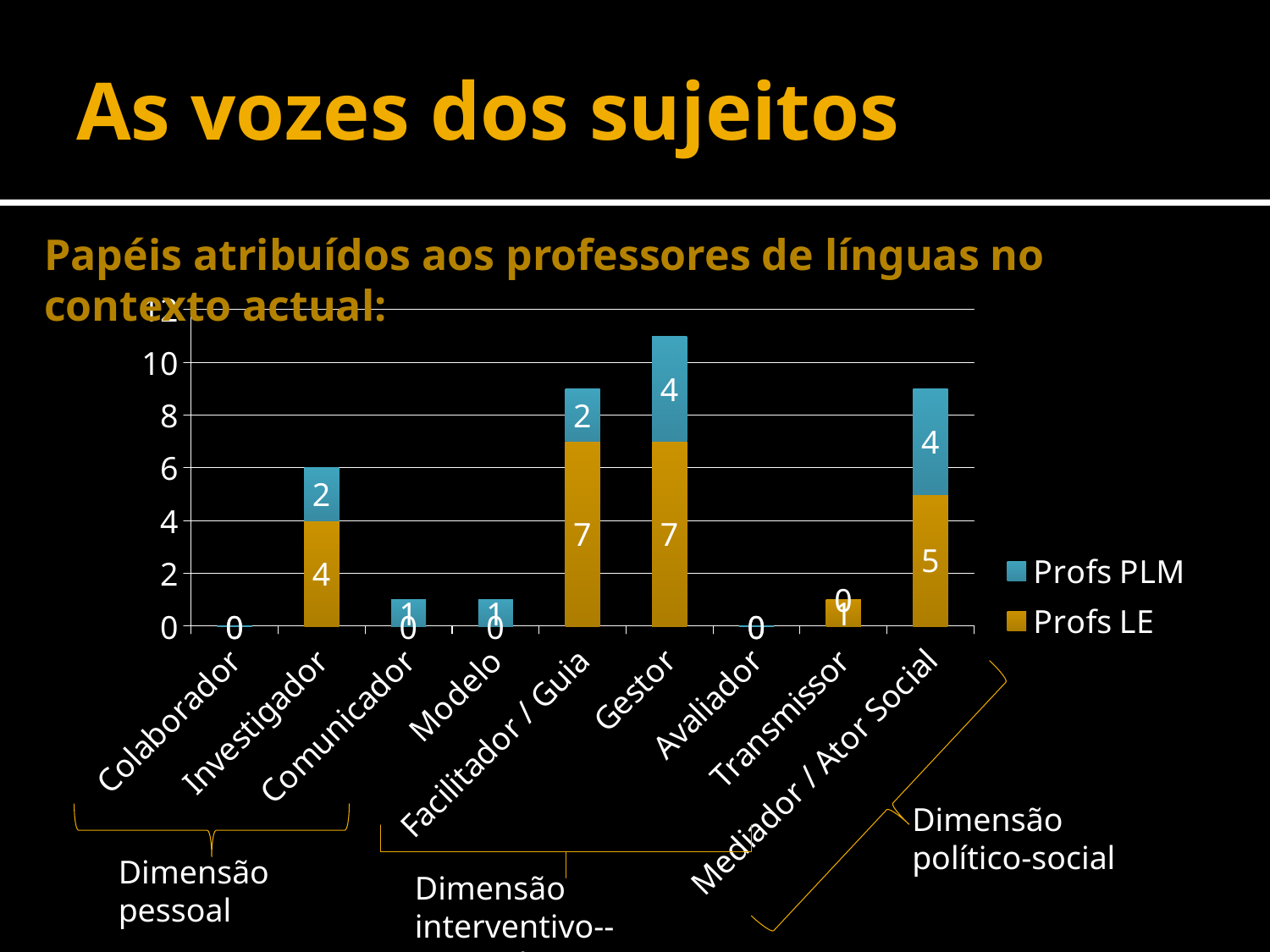
Which is larger for Investigador: the Profs LE value or the Profs PLM value? Profs LE Which category has the highest total stacked bar? Gestor What is the Profs LE value for Gestor? 7 What is the difference between the Profs LE value for Facilitador / Guia and the Profs LE value for Mediador / Ator Social? 2 How many series does the legend list? 2 What is the total of the stacked bar for Gestor? 11 What is the Profs PLM value for Facilitador / Guia? 2 How many categories are shown on the x axis? 9 What is the total of the stacked bar for Mediador / Ator Social? 9 What kind of chart is shown on the slide? Stacked bar chart What is the Profs LE value for Investigador? 4 What is the Profs PLM value for Mediador / Ator Social? 4